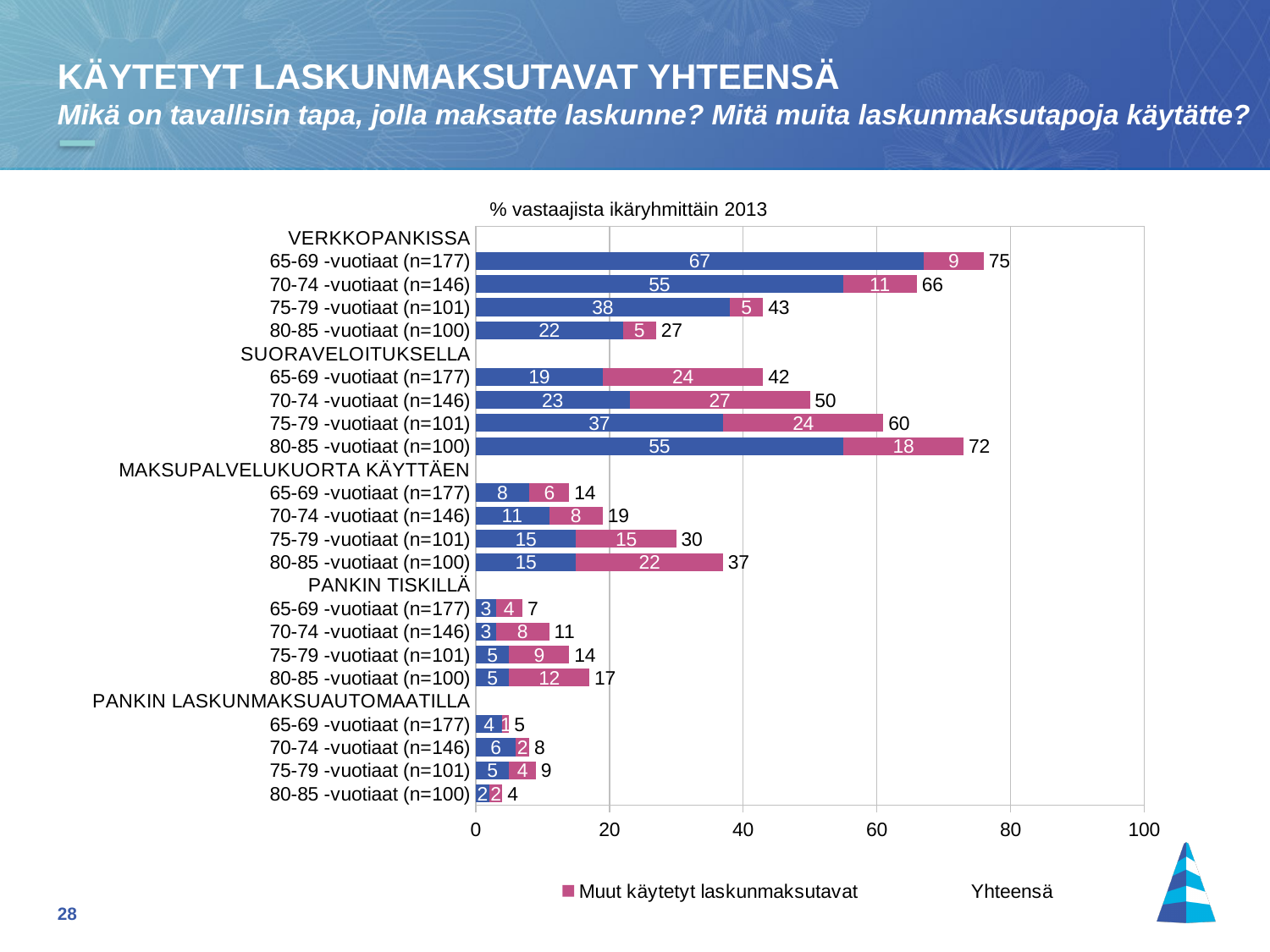
Which age group has the lowest total under PANKIN LASKUNMAKSUAUTOMAATILLA? 80-85 -vuotiaat (n=100) How do the totals change from the 65-69 age group to the 80-85 age group under PANKIN TISKILLÄ? They rise (7, 11, 14, 17) What is the title of the chart? % vastaajista ikäryhmittäin 2013 What is the difference between the totals for 80-85 -vuotiaat and 65-69 -vuotiaat under SUORAVELOITUKSELLA? 30 What is the blue segment value for 75-79 -vuotiaat under MAKSUPALVELUKUORTA KÄYTTÄEN? 15 What kind of chart is shown on the slide? Stacked horizontal bar chart Is the total for 80-85 -vuotiaat under VERKKOPANKISSA greater or less than 40? less How many payment method categories are shown on the chart? 5 What is the 'Muut käytetyt laskunmaksutavat' value for 80-85 -vuotiaat under SUORAVELOITUKSELLA? 18 Which age group has the highest total under VERKKOPANKISSA? 65-69 -vuotiaat (n=177) Which is larger: the total for 70-74 -vuotiaat under VERKKOPANKISSA or the total for 70-74 -vuotiaat under SUORAVELOITUKSELLA? VERKKOPANKISSA (66) What is the total (Yhteensä) value for 65-69 -vuotiaat under VERKKOPANKISSA? 75